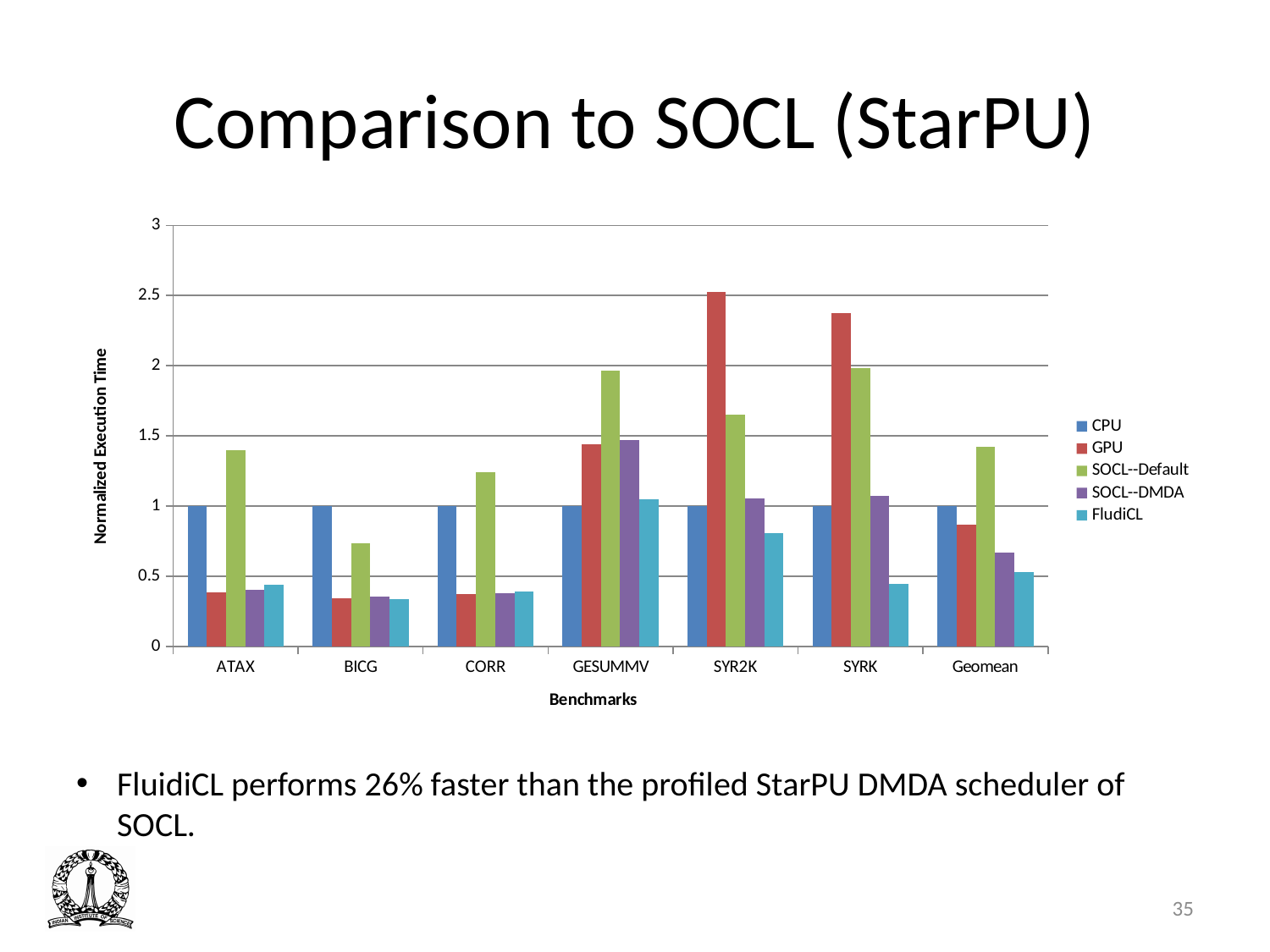
Is the GPU value for SYR2K greater or less than 2? greater How many benchmark categories are shown on the x axis? 7 For SYRK, which is larger: the GPU value or the SOCL--Default value? GPU What is the title of the chart? Comparison to SOCL (StarPU) Which benchmark has the highest GPU value? SYR2K What kind of chart is shown on the slide? bar chart What is the CPU value for ATAX? 1 How many series does the legend list? 5 Is the FluidiCL value for BICG greater or less than 0.5? less Which series has the lowest value for Geomean? FluidiCL Is the SOCL--Default value for ATAX greater or less than 1? greater What is the title of the y axis? Normalized Execution Time